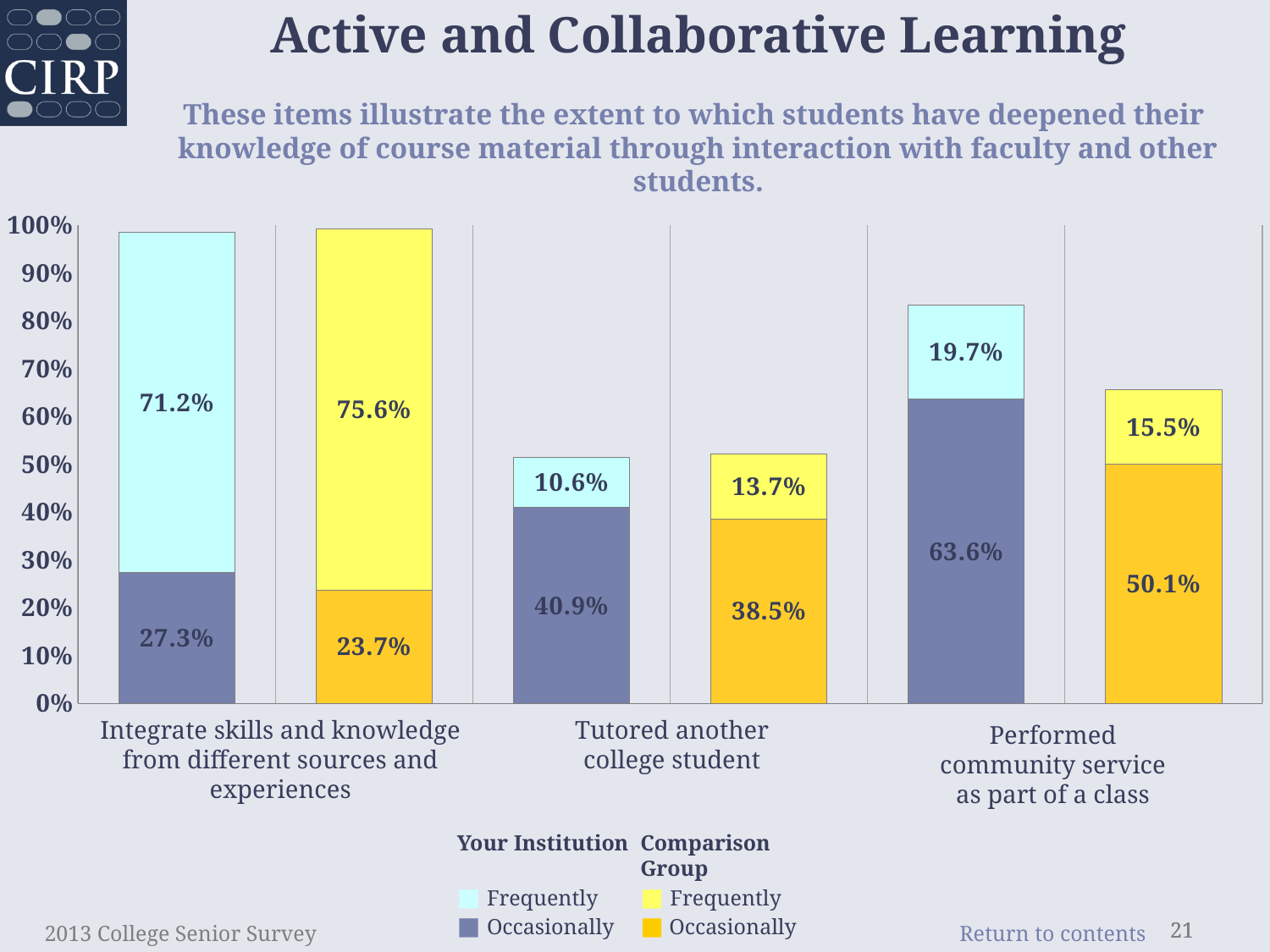
What is the 'Occasionally' value for the Comparison Group for 'Tutored another college student'? 38.5% Across all bars, which 'Frequently' value is the lowest? 10.6% (Your Institution, Tutored another college student) What type of chart is shown on the slide? Stacked bar chart What is the 'Frequently' value for the Comparison Group for 'Performed community service as part of a class'? 15.5% What is the total of the Your Institution stacked bar for 'Tutored another college student'? 51.5% What is the 'Occasionally' value for Your Institution for 'Performed community service as part of a class'? 63.6% How many series does the legend list? 4 Which is larger for 'Performed community service as part of a class': the 'Occasionally' value for Your Institution or for the Comparison Group? Your Institution What percentage of students at Your Institution reported 'Frequently' for 'Integrate skills and knowledge from different sources and experiences'? 71.2% What is the total of the Comparison Group stacked bar for 'Performed community service as part of a class'? 65.6% What is the difference between the Comparison Group and Your Institution 'Frequently' values for 'Integrate skills and knowledge from different sources and experiences'? 4.4% Across all bars, which 'Frequently' value is the highest? 75.6% (Comparison Group, Integrate skills and knowledge)